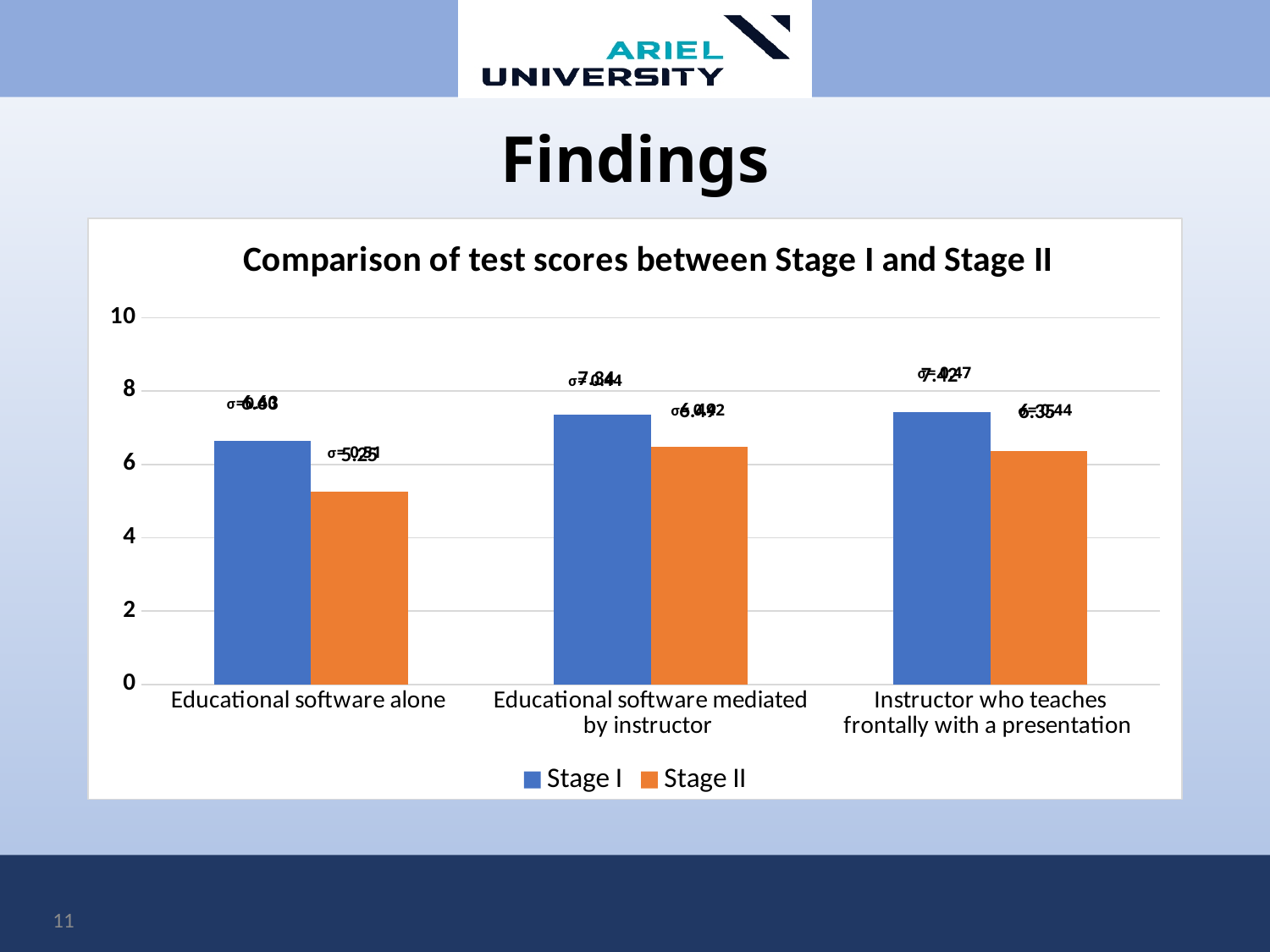
For Instructor who teaches frontally with a presentation, which is larger, the Stage I or the Stage II score? Stage I What is the title of the chart? Comparison of test scores between Stage I and Stage II Which category has the lowest Stage I score? Educational software alone For Educational software alone, which is larger, the Stage I or the Stage II score? Stage I How many categories are shown on the x axis? 3 Is the Stage I value for Educational software mediated by instructor greater or less than 8? less Is the Stage II value for Educational software alone greater or less than 6? less Which category has the lowest Stage II score? Educational software alone Is the Stage I value for Educational software alone greater or less than 6? greater How many series does the legend list? 2 Which colour represents Stage II in the chart? orange What type of chart is shown on the slide? bar chart